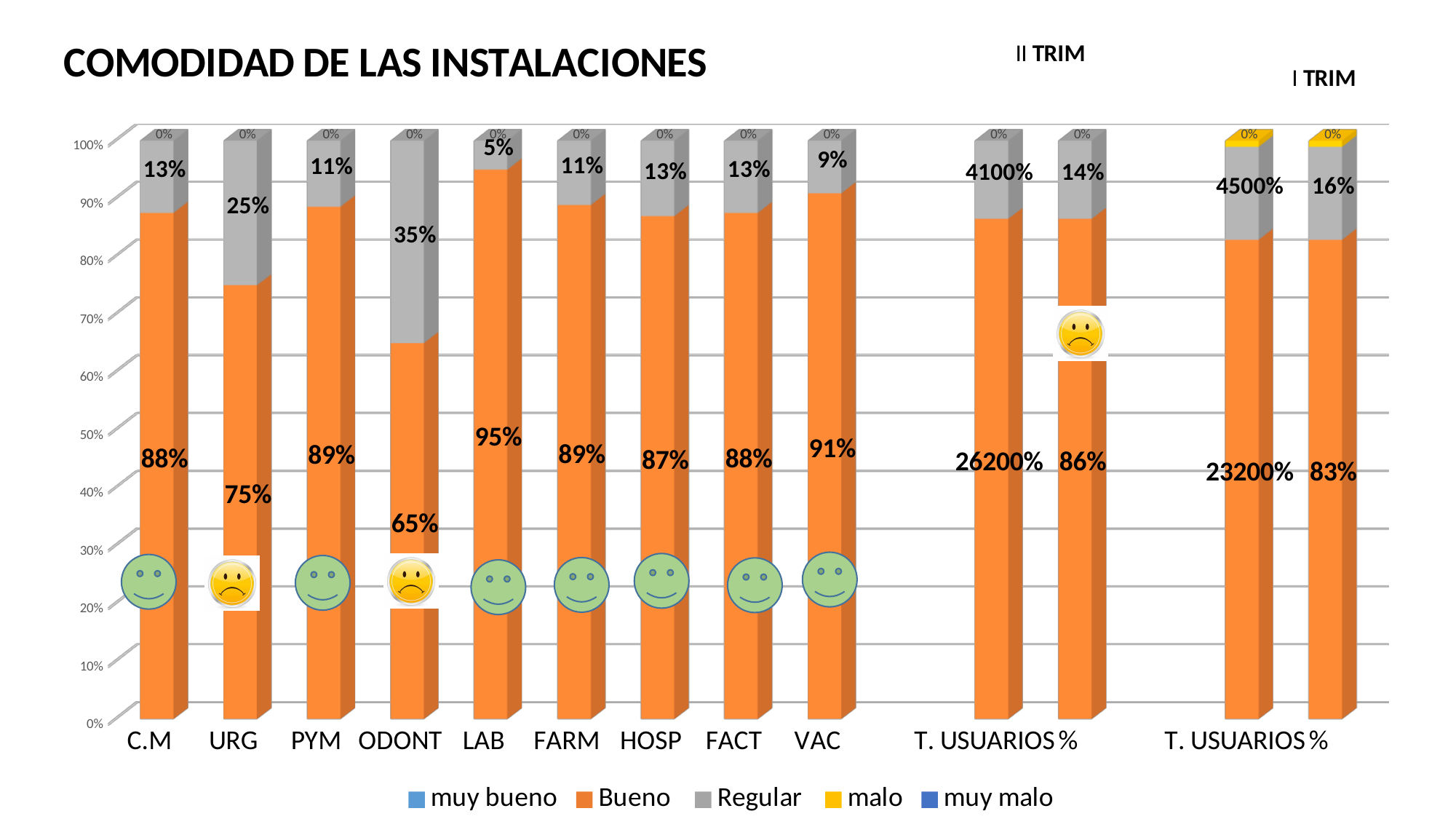
How many series does the legend list? 5 Among C.M, URG, PYM, ODONT, LAB, FARM, HOSP, FACT and VAC, which category has the lowest Bueno value? ODONT What is the Regular value for URG? 25% What is the Bueno value for LAB? 95% Which has a larger Bueno value, URG or VAC? VAC What is the Regular value for VAC? 9% What is the difference between the Regular values for ODONT and LAB? 30% Which legend entry is shown in orange? Bueno What is the title of the chart? COMODIDAD DE LAS INSTALACIONES Among C.M, URG, PYM, ODONT, LAB, FARM, HOSP, FACT and VAC, which category has the highest Bueno value? LAB What is the Bueno value for ODONT? 65% What type of chart is shown on the slide? Stacked bar chart